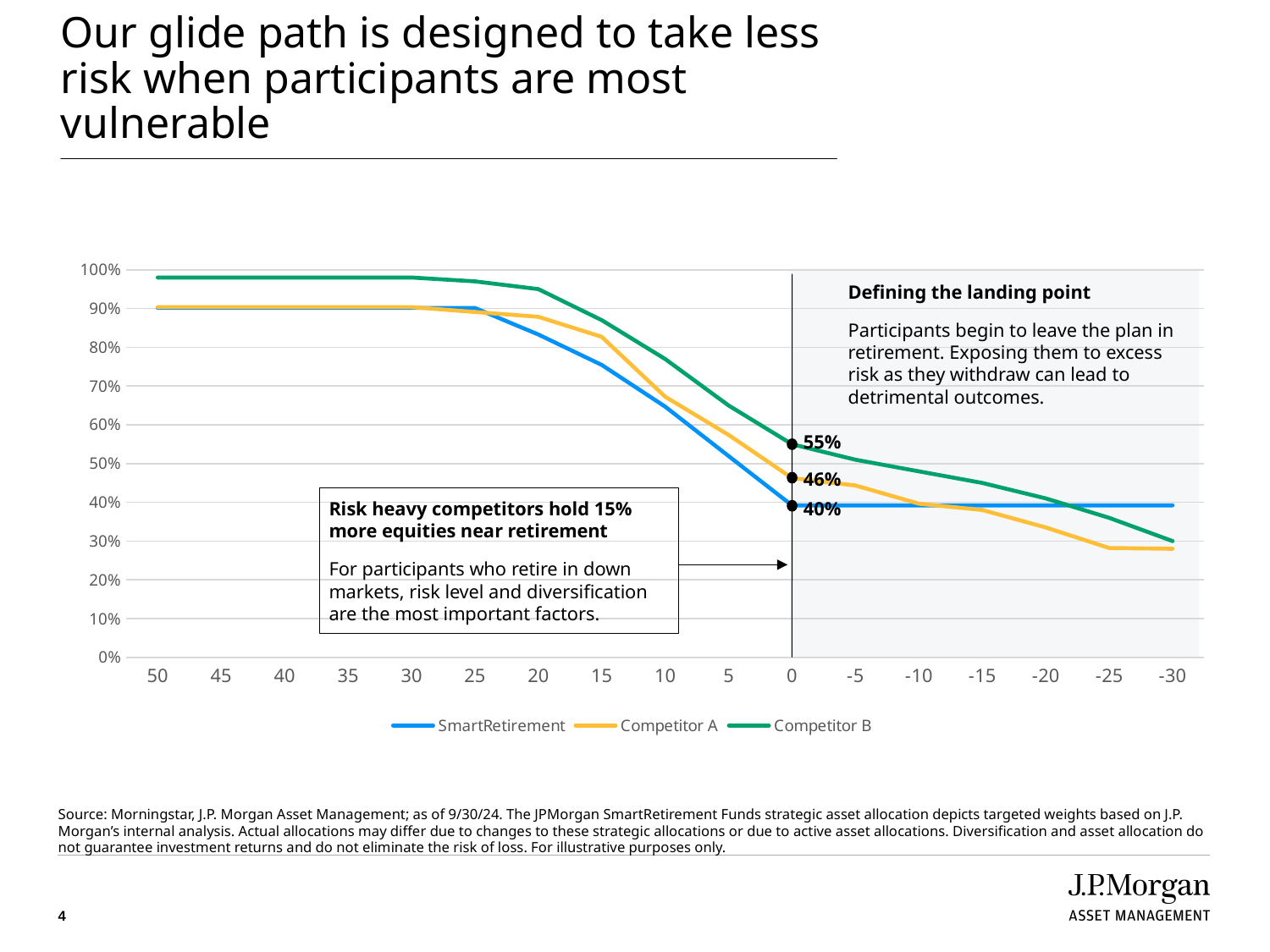
How many series does the legend list? 3 Is the value for Competitor B at -30 on the x axis greater or less than 40%? less What is the difference between the labelled values of Competitor B and SmartRetirement at 0 on the x axis? 15 percentage points At 0 on the x axis, which series has the lowest labelled value? SmartRetirement Do the values for Competitor A rise or fall moving from 50 to -30 along the x axis? Fall Is the value for SmartRetirement at 50 on the x axis greater or less than 80%? greater What is the labelled value for Competitor B at 0 on the x axis? 55% What kind of chart is shown on the slide? Line chart What is the labelled value for Competitor A at 0 on the x axis? 46% At 0 on the x axis, which is larger: the value for Competitor A or the value for SmartRetirement? Competitor A At 0 on the x axis, which series has the highest labelled value? Competitor B What is the labelled value for SmartRetirement at 0 on the x axis? 40%